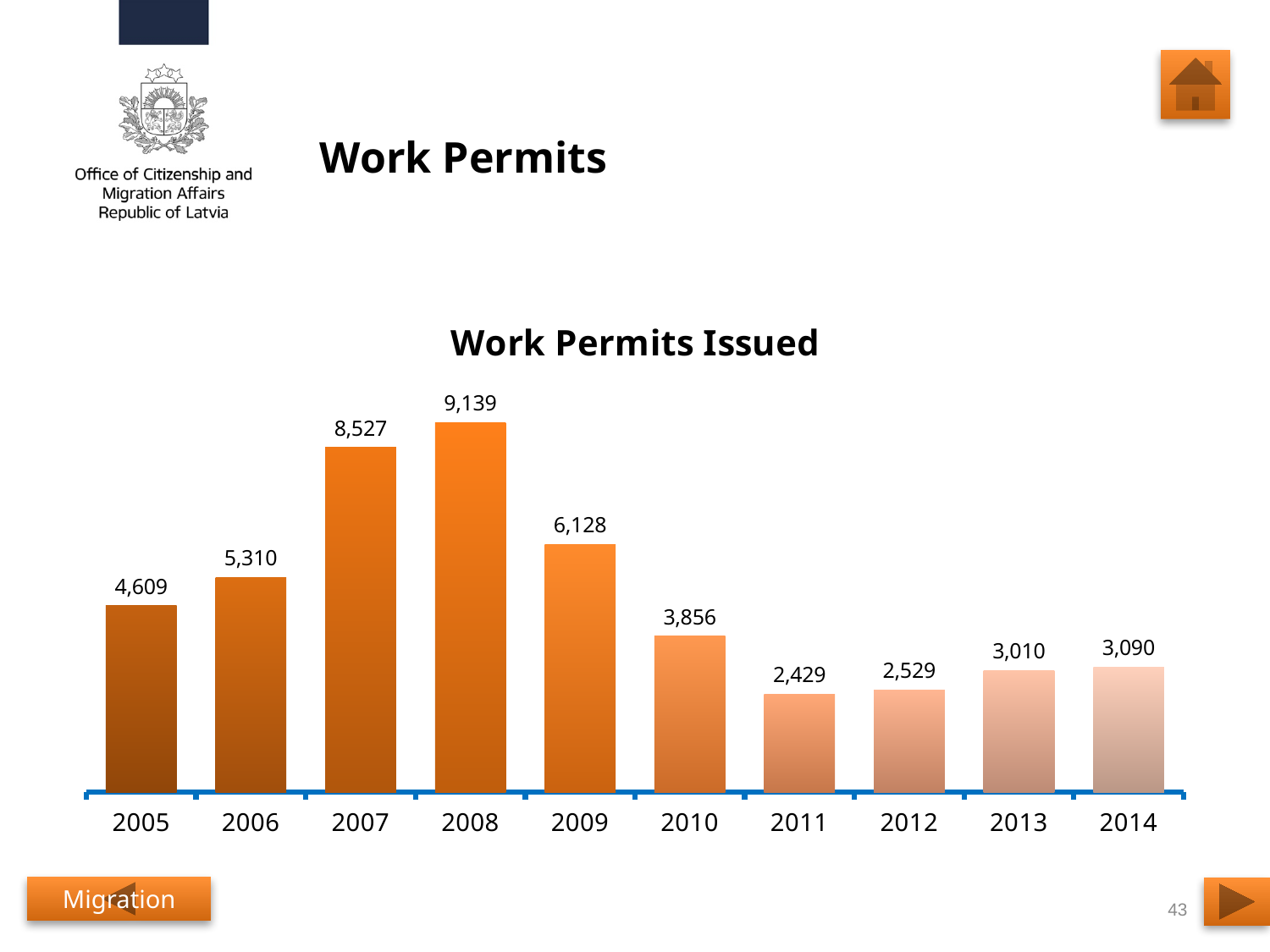
Which year has the lowest number of work permits issued? 2011 What is the difference between the values for 2014 and 2013? 80 Which year has the highest number of work permits issued? 2008 How many years are shown on the x axis of the chart? 10 How many work permits were issued in 2011? 2,429 What is the value for 2008 in the Work Permits Issued chart? 9,139 What is the value shown for 2005? 4,609 What is the title of the chart? Work Permits Issued What is the difference between the values for 2008 and 2007? 612 Which year has a larger value, 2009 or 2010? 2009 What kind of chart is shown on the slide? Bar chart Do the values rise or fall from 2008 to 2011? Fall